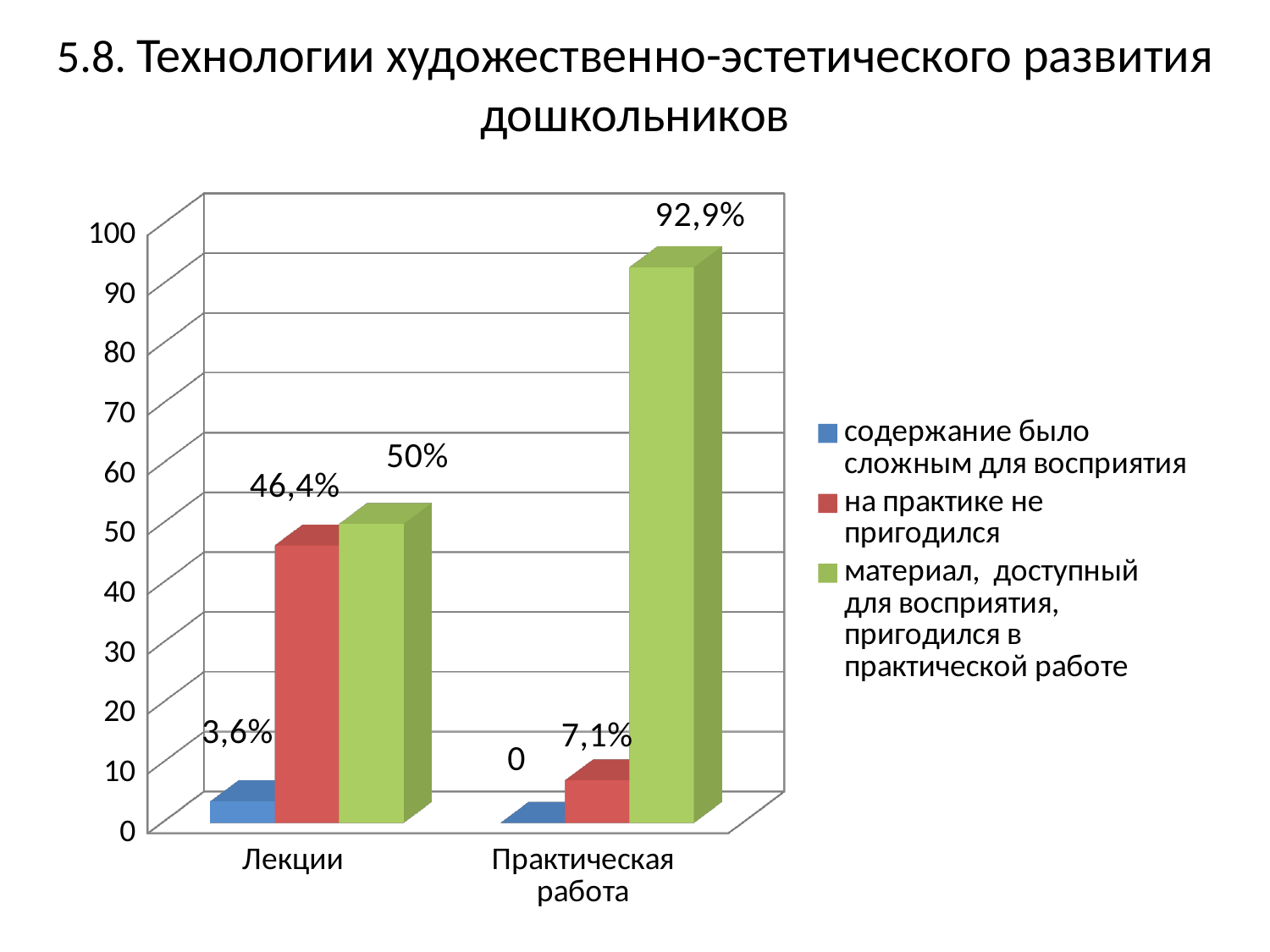
What kind of chart is shown on the slide? bar chart What is the value for "на практике не пригодился" in the "Лекции" category? 46,4% Which series has the lowest value in the "Практическая работа" category? содержание было сложным для восприятия What is the difference between the "материал, доступный для восприятия, пригодился в практической работе" values for "Практическая работа" and "Лекции"? 42,9% How many categories are shown on the x axis of the chart? 2 Which category has the highest value for "материал, доступный для восприятия, пригодился в практической работе"? Практическая работа What colour are the bars for the series "на практике не пригодился"? red How many series does the chart legend list? 3 What is the value for "материал, доступный для восприятия, пригодился в практической работе" in the "Практическая работа" category? 92,9% What is the value for "содержание было сложным для восприятия" in the "Лекции" category? 3,6% Which is larger: the "на практике не пригодился" value for "Лекции" or for "Практическая работа"? Лекции What is the value for "содержание было сложным для восприятия" in the "Практическая работа" category? 0